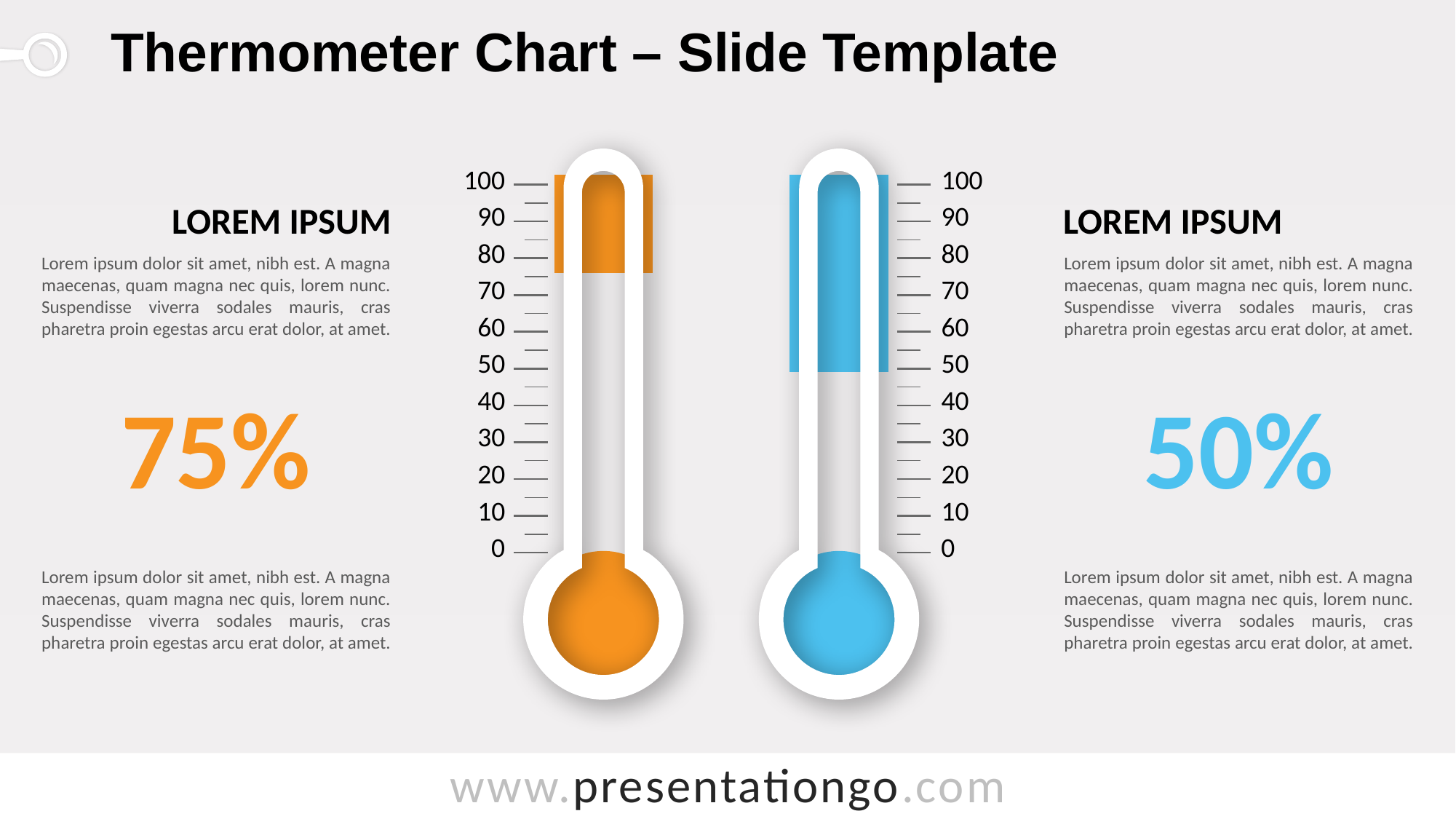
What colour is the fill of the left thermometer? Orange What is the highest value labelled on the thermometer scales? 100 Which thermometer shows the lowest value? The blue one on the right (50%) What is the difference between the orange thermometer's value and the blue thermometer's value? 25 percentage points How many thermometers are shown on the slide? 2 What percentage value is shown for the right (blue) thermometer? 50% What percentage value is shown for the left (orange) thermometer? 75% Is the value for the orange thermometer greater or less than 50? greater What kind of chart is shown on the slide? Thermometer chart How many labelled tick marks are on each thermometer scale? 11 Is the value for the blue thermometer greater or less than 70? less Which thermometer shows the higher value, the orange one on the left or the blue one on the right? The orange one on the left (75%)